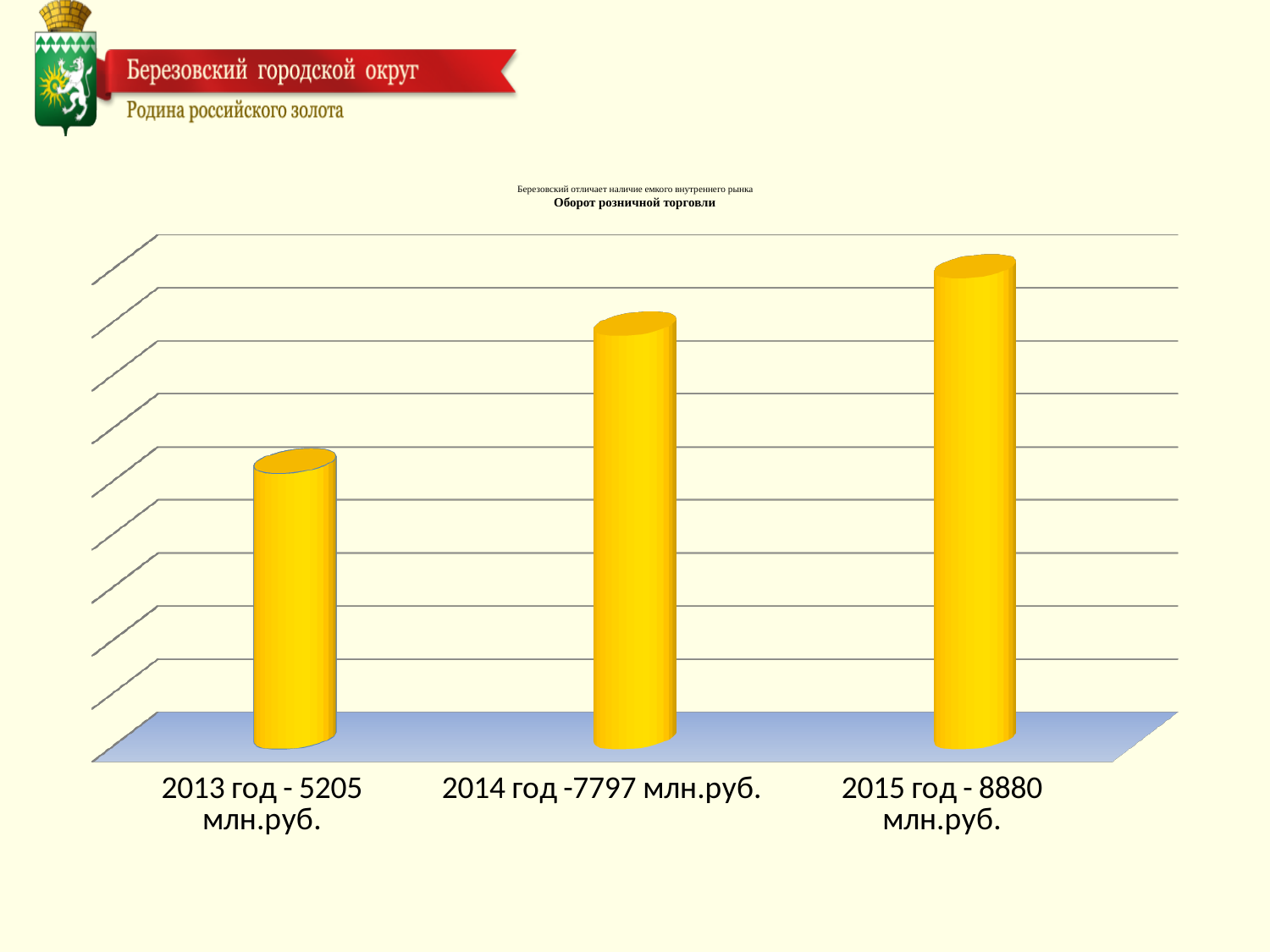
Which year has the lowest retail trade turnover? 2013 What is the retail trade turnover value shown for 2015? 8880 млн.руб. What is the difference between the 2015 and 2013 values? 3675 млн.руб. What kind of chart is shown on the slide? Bar chart Do the values rise or fall from 2013 to 2015? Rise What is the difference between the 2015 and 2014 values? 1083 млн.руб. Which year has the highest retail trade turnover? 2015 What is the difference between the 2014 and 2013 values? 2592 млн.руб. What is the retail trade turnover value shown for 2013? 5205 млн.руб. What is the retail trade turnover value shown for 2014? 7797 млн.руб. How many years (bars) are shown in the chart? 3 Which is larger, the value for 2014 or the value for 2015? 2015